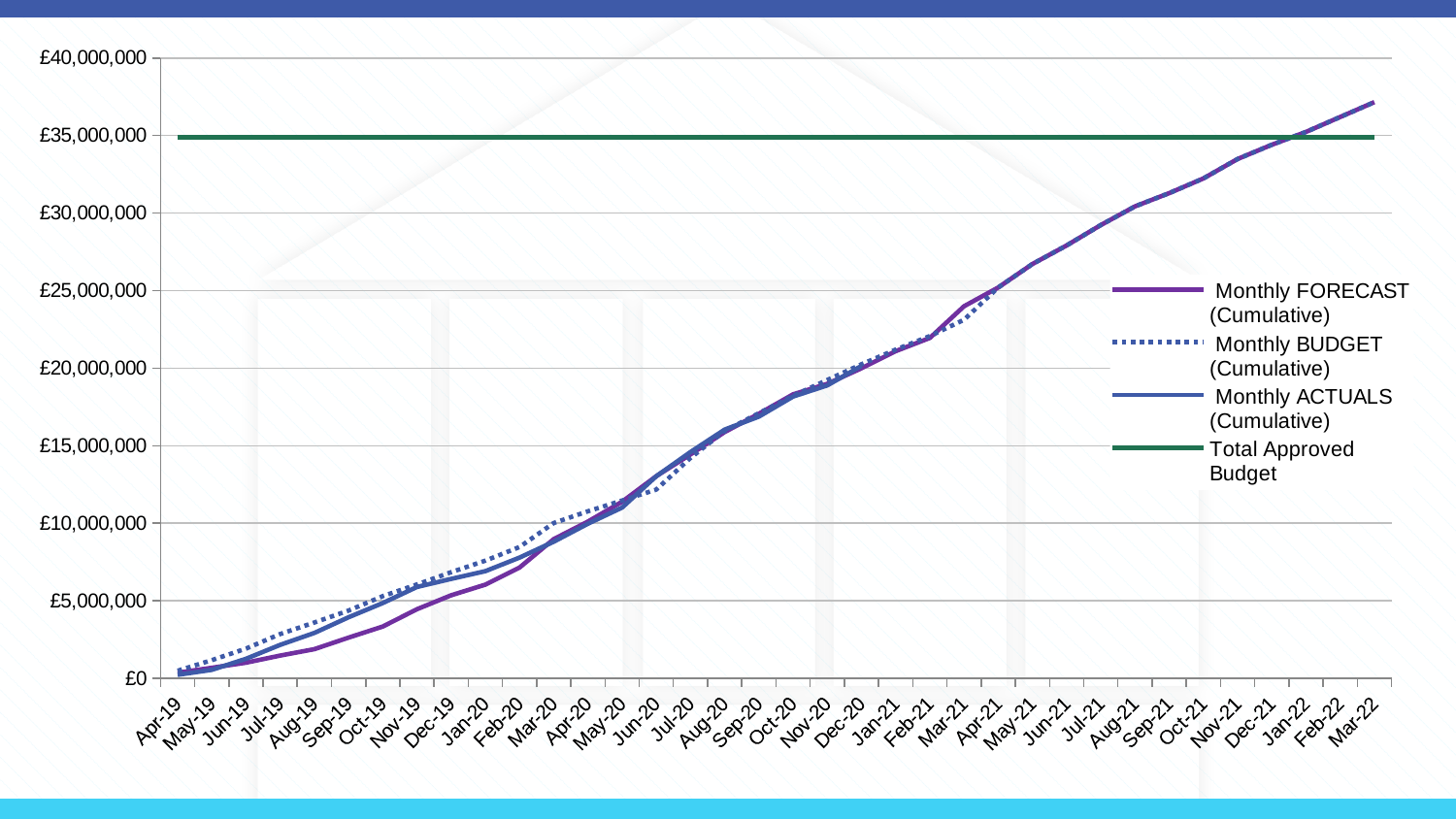
At Feb-20, which is higher: Monthly BUDGET (Cumulative) or Monthly FORECAST (Cumulative)? Monthly BUDGET (Cumulative) Is the Monthly BUDGET (Cumulative) value at Feb-20 greater or less than £10,000,000? less What is the first month shown on the x axis? Apr-19 Do the Monthly FORECAST (Cumulative) values rise or fall from Apr-19 to Mar-22? Rise At Nov-19, which is higher: Monthly ACTUALS (Cumulative) or Monthly FORECAST (Cumulative)? Monthly ACTUALS (Cumulative) How many series does the legend list? 4 Is the Monthly FORECAST (Cumulative) value at Aug-20 greater or less than £15,000,000? greater Which series is drawn as a dotted line? Monthly BUDGET (Cumulative) Is the Monthly FORECAST (Cumulative) value at Mar-22 greater or less than £35,000,000? greater How many months are shown along the x axis? 36 What kind of chart is shown on the slide? Line chart